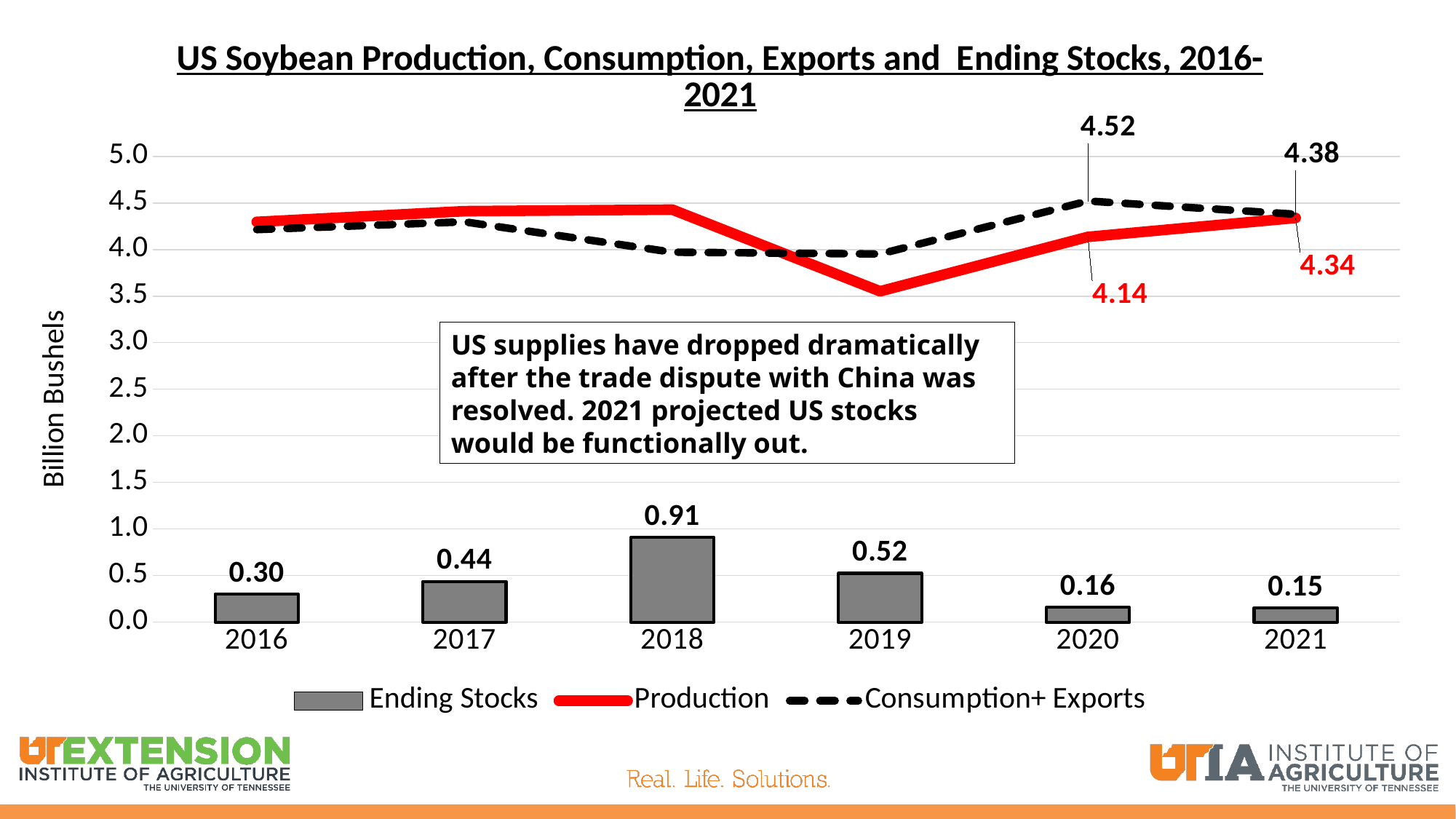
What is the Ending Stocks value for 2018? 0.91 In 2020, which is larger: Production or Consumption+ Exports? Consumption+ Exports How many series does the legend list? 3 How many years are shown on the x axis? 6 Do the Ending Stocks values rise or fall from 2018 to 2021? fall Which year has the lowest Ending Stocks? 2021 What is the Production value for 2021? 4.34 Is the Production value for 2019 greater or less than 4.0? less What is the Consumption+ Exports value for 2020? 4.52 Which year has the highest Ending Stocks? 2018 What is the difference between Ending Stocks in 2018 and 2019? 0.39 What is the label on the vertical axis? Billion Bushels